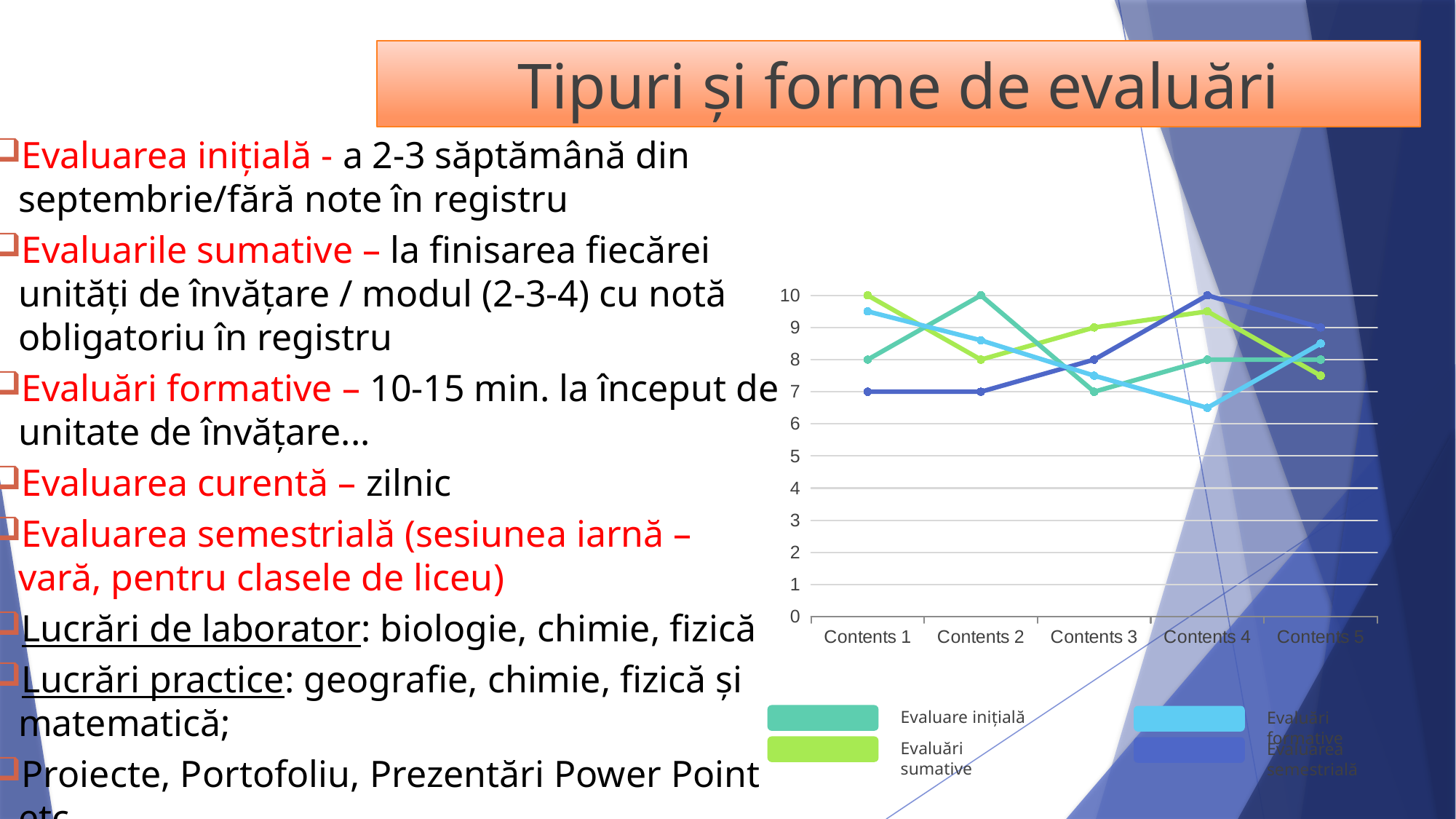
How many categories are shown on the x axis of the chart? 5 At Contents 1, which is larger: Evaluare inițială or Evaluări sumative? Evaluări sumative What is the value of Evaluări sumative at Contents 1? 10 At which category does Evaluare inițială have its lowest value? Contents 3 What kind of chart is shown on the slide? line chart At which category does Evaluare inițială reach its highest value? Contents 2 What is the value of Evaluare inițială at Contents 3? 7 How many series does the chart's legend list? 4 What is the difference between Evaluări sumative at Contents 1 and at Contents 2? 2 What is the value of Evaluare inițială at Contents 2? 10 Is the value of Evaluări sumative at Contents 4 greater or less than 9? greater What is the value of Evaluări sumative at Contents 3? 9